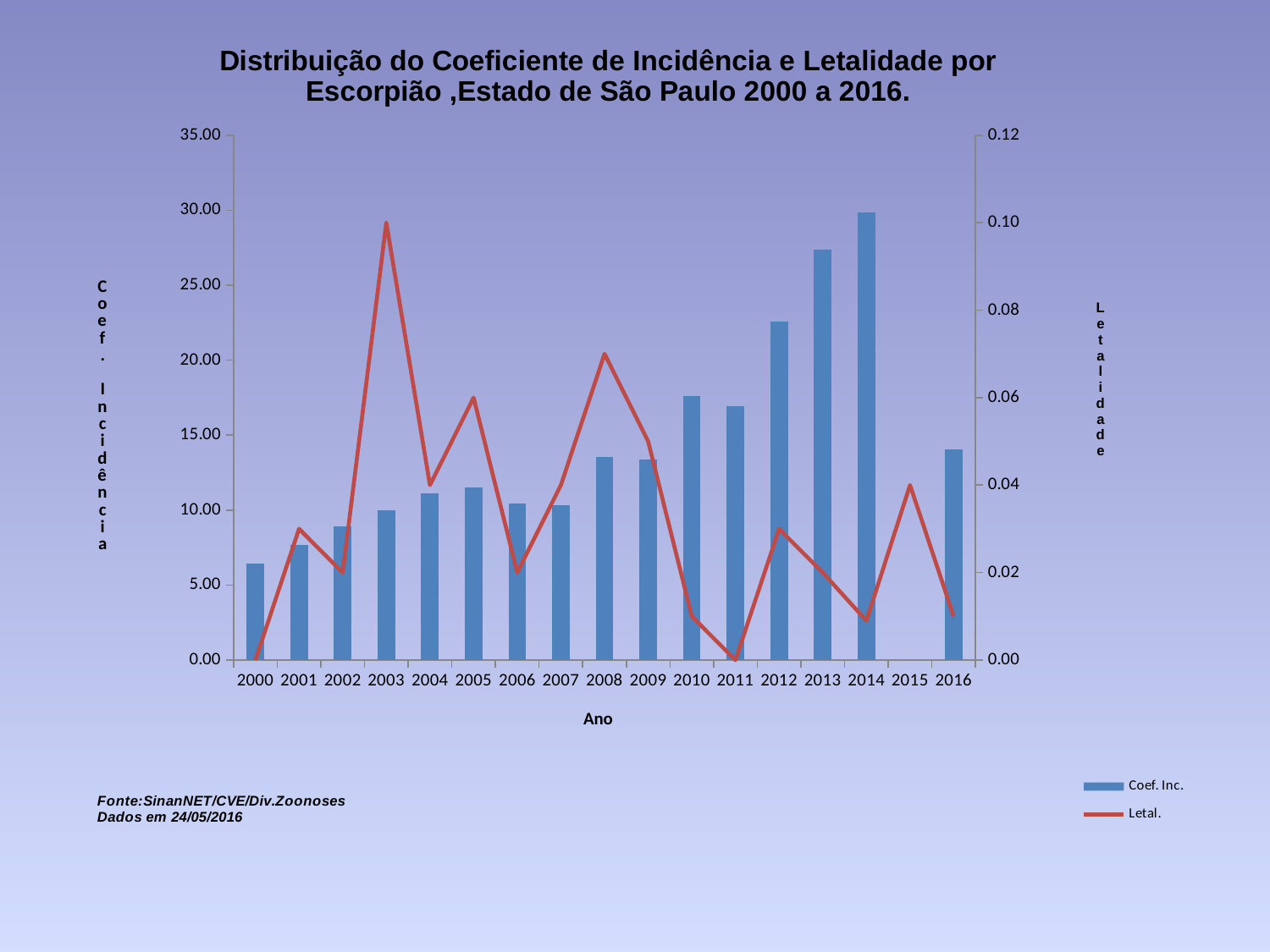
Is the Coef. Inc. value for 2000 greater or less than 10.00? less Which year has the lowest Coef. Inc. bar among the years with a bar? 2000 What type of chart is shown on the slide? Combined bar and line chart Do the Coef. Inc. bars generally rise or fall from 2000 to 2014? rise Which year has the highest Coef. Inc. bar? 2014 How many series does the legend list? 2 How many years are shown on the x axis? 17 What is the title of the x axis? Ano Which year has the larger Coef. Inc. bar, 2012 or 2013? 2013 In which year does the Letal. line reach its highest point? 2003 Is the Coef. Inc. value for 2014 greater or less than 25.00? greater Is the Letal. value for 2008 greater or less than 0.06? greater